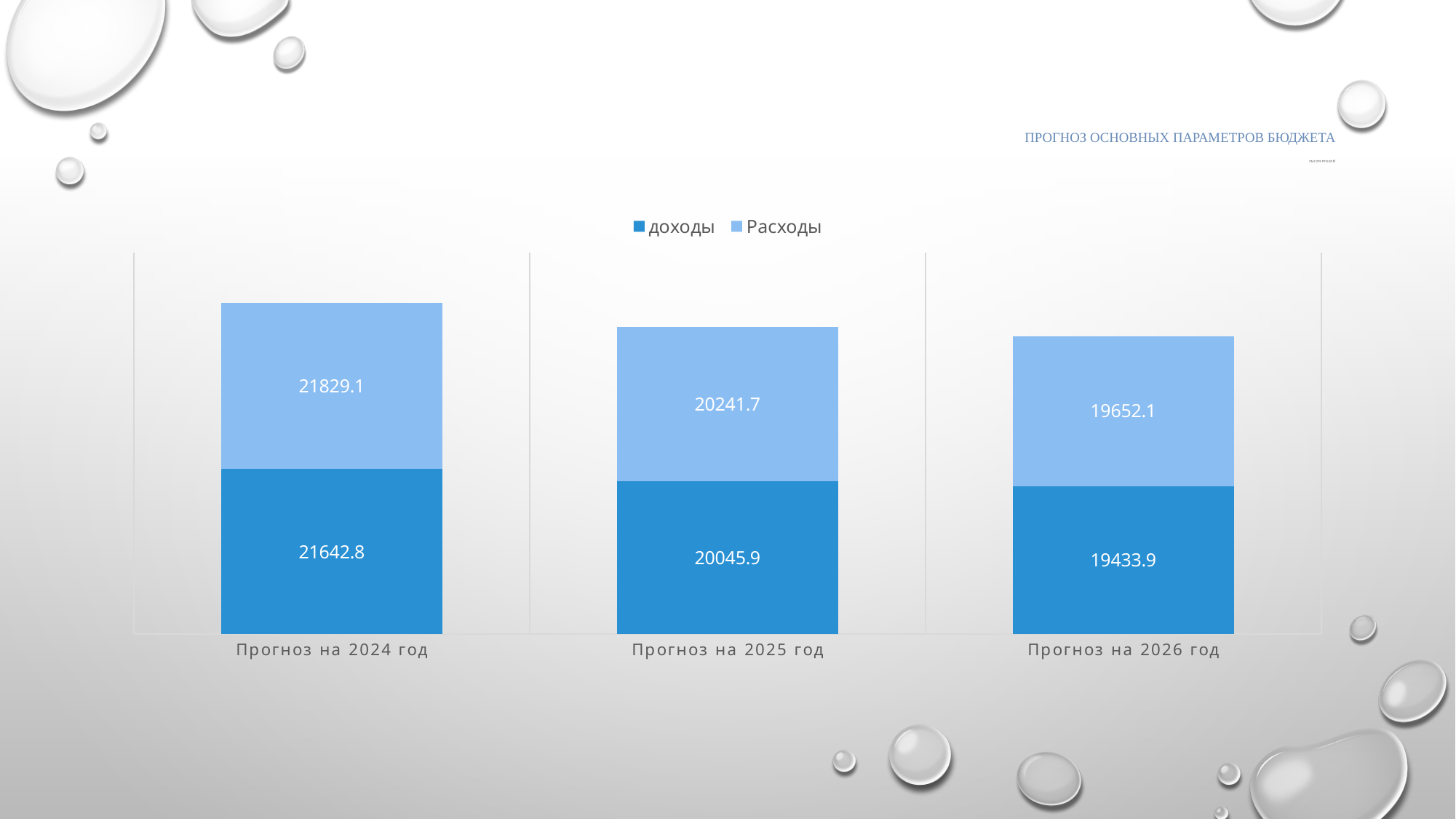
Which category has the lowest value for Расходы? Прогноз на 2026 год What is the difference between Расходы and доходы for Прогноз на 2024 год? 186.3 What is the difference between доходы for Прогноз на 2024 год and доходы for Прогноз на 2025 год? 1596.9 What is the value of доходы for Прогноз на 2024 год? 21642.8 What is the value of Расходы for Прогноз на 2026 год? 19652.1 What is the total of the stacked bar for Прогноз на 2025 год? 40287.6 How many categories are shown on the x axis? 3 What is the value of Расходы for Прогноз на 2025 год? 20241.7 What kind of chart is shown on the slide? Stacked bar chart Which is larger for Прогноз на 2026 год: доходы or Расходы? Расходы Which category has the highest value for доходы? Прогноз на 2024 год How many series does the legend list? 2